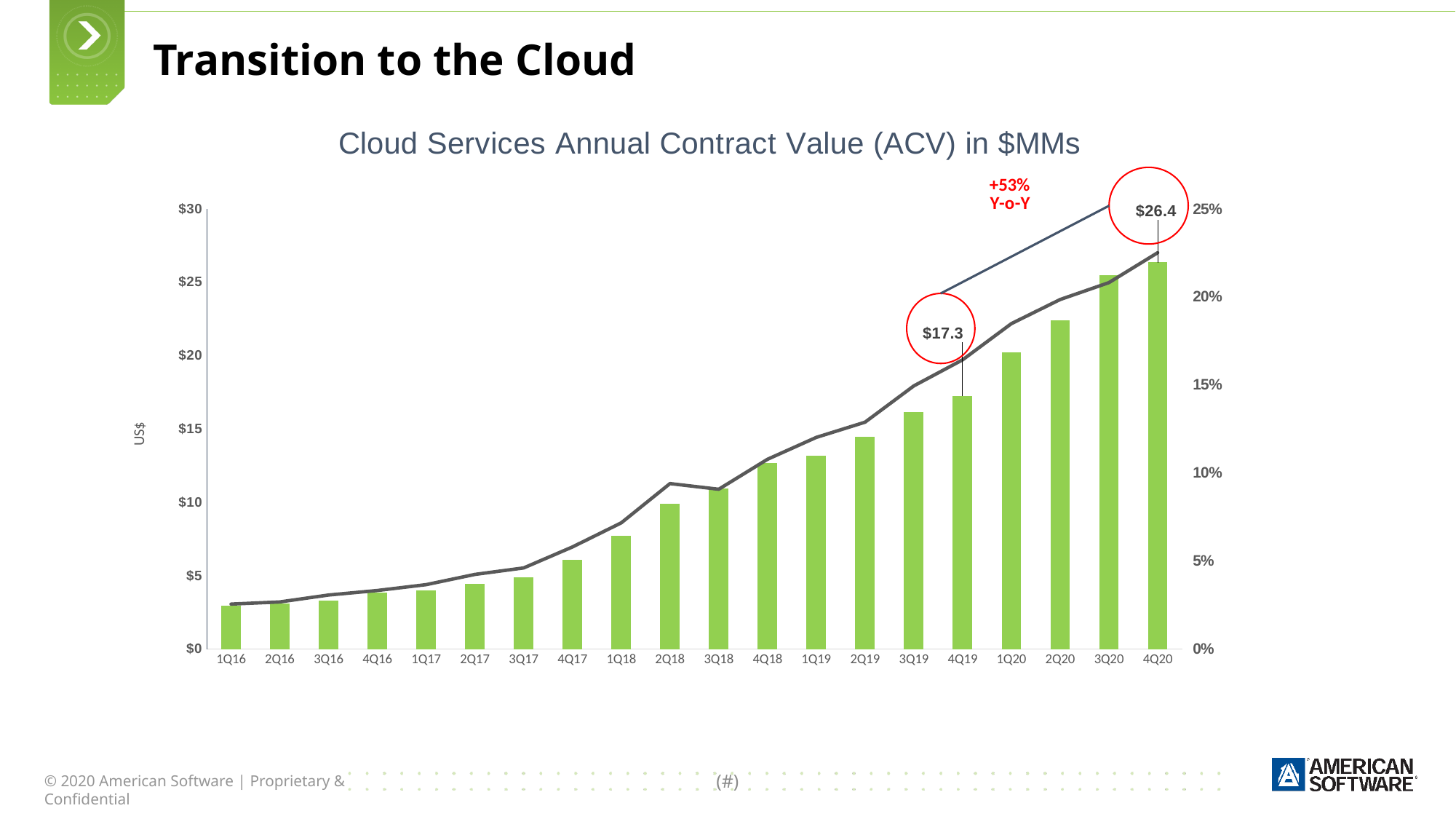
Is the bar value for 1Q18 greater or less than $10? less What is the labelled value for 4Q20? $26.4 Is the bar value for 2Q20 greater or less than $20? greater What is the labelled value for 4Q19? $17.3 Do the bar values rise or fall from 1Q16 to 4Q20? Rise What is the title of the chart? Cloud Services Annual Contract Value (ACV) in $MMs Which quarter has the lowest bar? 1Q16 What kind of chart is this? A bar chart with a line overlay What is the difference between the labelled values for 4Q20 and 4Q19? $9.1 Which quarter has the highest bar? 4Q20 Which has the larger bar, 2Q20 or 3Q20? 3Q20 How many quarters are shown on the x axis? 20